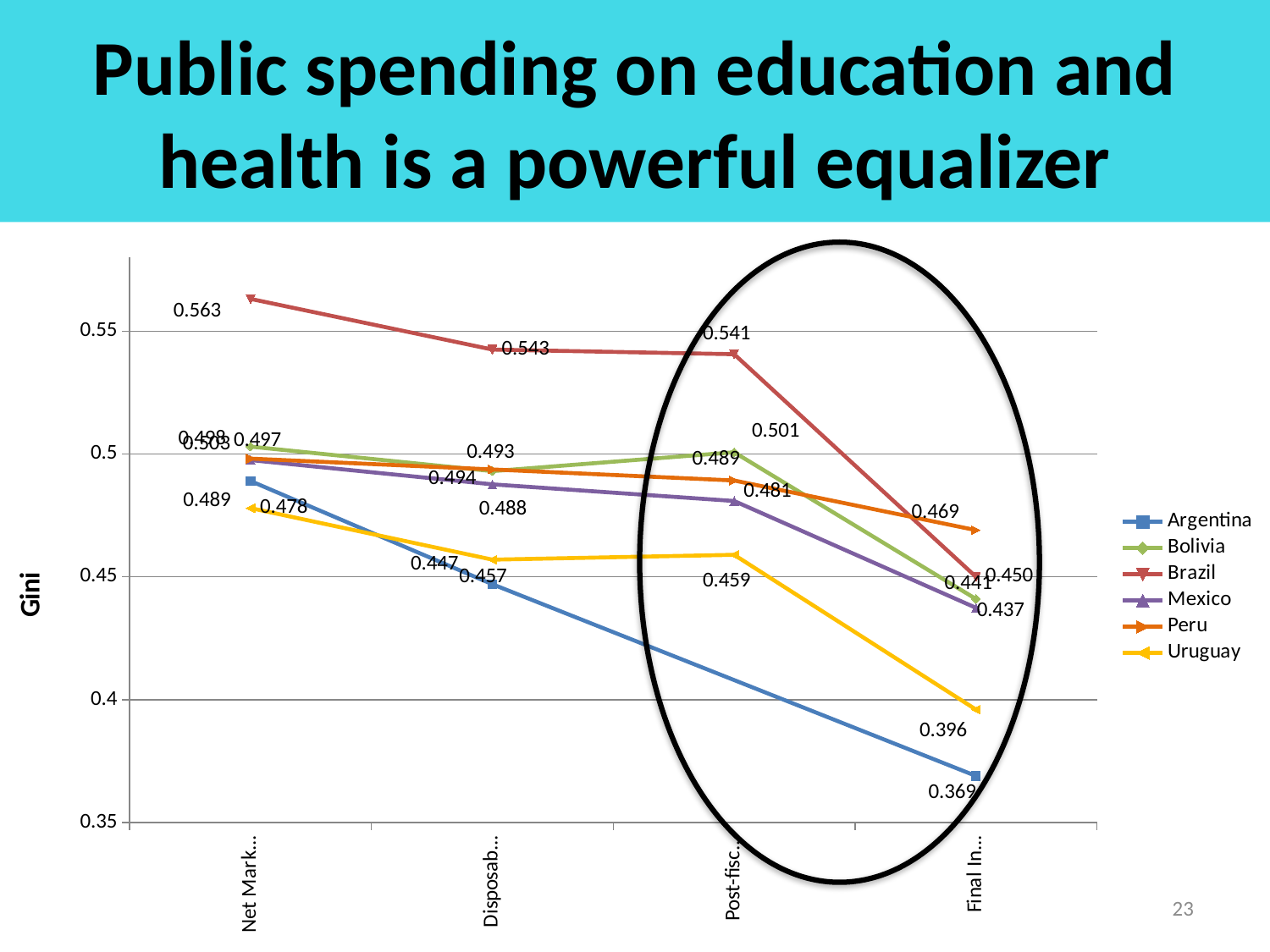
Which country has the highest Gini value at the first category (Net Mark...)? Brazil Which country has the lowest Gini value at the last category (Final In...)? Argentina What is the title of the y axis? Gini What is the Gini value for Uruguay at the last category (Final In...)? 0.396 What is the Gini value for Brazil at the first category (Net Mark...)? 0.563 How many categories are plotted along the x axis? 4 How many series does the legend list? 6 What is the difference between Brazil's Gini value at the first category (0.563) and at the last category (0.450)? 0.113 What kind of chart is shown on the slide? line chart What is the Gini value for Argentina at the last category (Final In...)? 0.369 What is the Gini value for Peru at the last category (Final In...)? 0.469